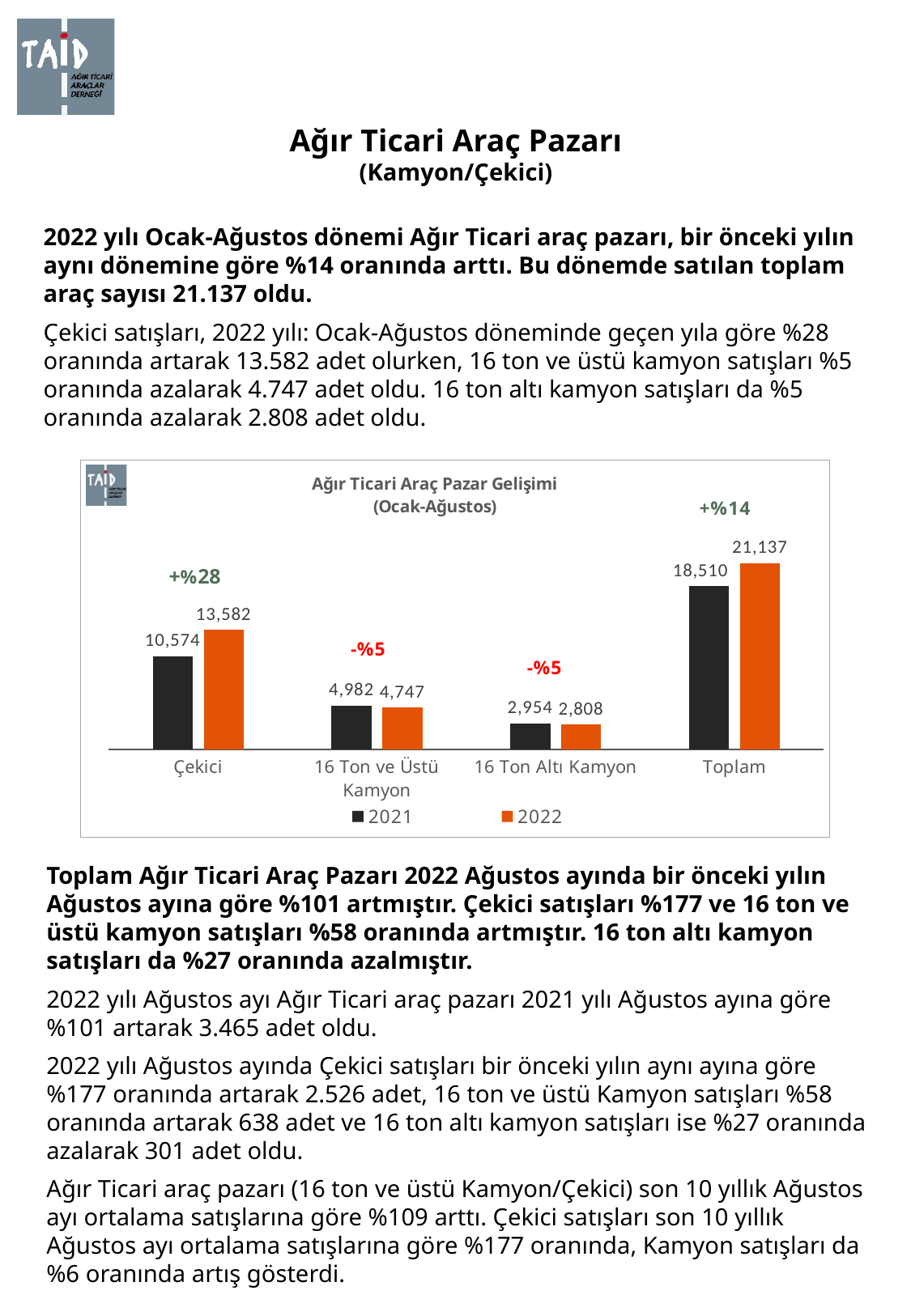
What percentage change label is shown above the Toplam bars? +%14 What is the 2021 value for 16 Ton ve Üstü Kamyon? 4,982 What is the 2022 value for 16 Ton Altı Kamyon? 2,808 Excluding Toplam, which category has the highest 2021 value? Çekici What is the difference between the 2021 and 2022 values for 16 Ton ve Üstü Kamyon? 235 How many categories are shown on the x axis of the chart? 4 What is the 2021 value for Toplam? 18,510 Is the 2022 value for 16 Ton Altı Kamyon larger or smaller than its 2021 value? smaller What is the difference between the 2022 and 2021 values for Çekici? 3,008 Which category has the lowest 2022 value? 16 Ton Altı Kamyon How many series does the chart legend list? 2 What is the 2022 value for Çekici in the chart? 13,582